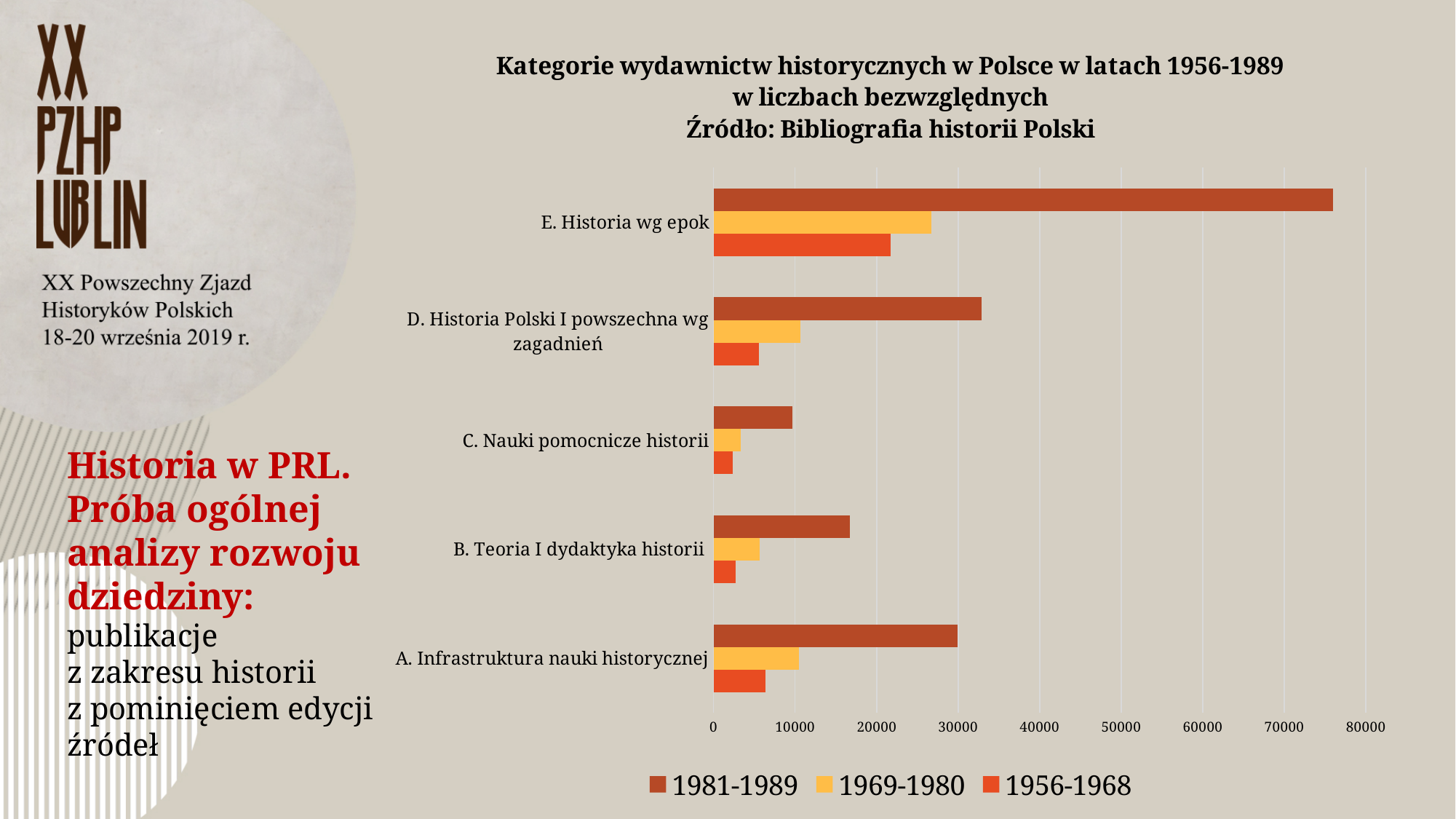
What kind of chart is shown on the slide? bar chart Which series is shown in yellow in the legend? 1969-1980 Which category has the lowest value for the 1981-1989 series? C. Nauki pomocnicze historii For the 1981-1989 series, which is larger: E. Historia wg epok or D. Historia Polski I powszechna wg zagadnień? E. Historia wg epok Which category has the lowest value for the 1956-1968 series? C. Nauki pomocnicze historii Is the 1981-1989 value for B. Teoria I dydaktyka historii greater or less than 10000? greater Which category has the highest value for the 1981-1989 series? E. Historia wg epok Is the 1981-1989 value for E. Historia wg epok greater or less than 70000? greater How many categories are shown on the chart? 5 Is the 1969-1980 value for E. Historia wg epok greater or less than 20000? greater How many series does the legend list? 3